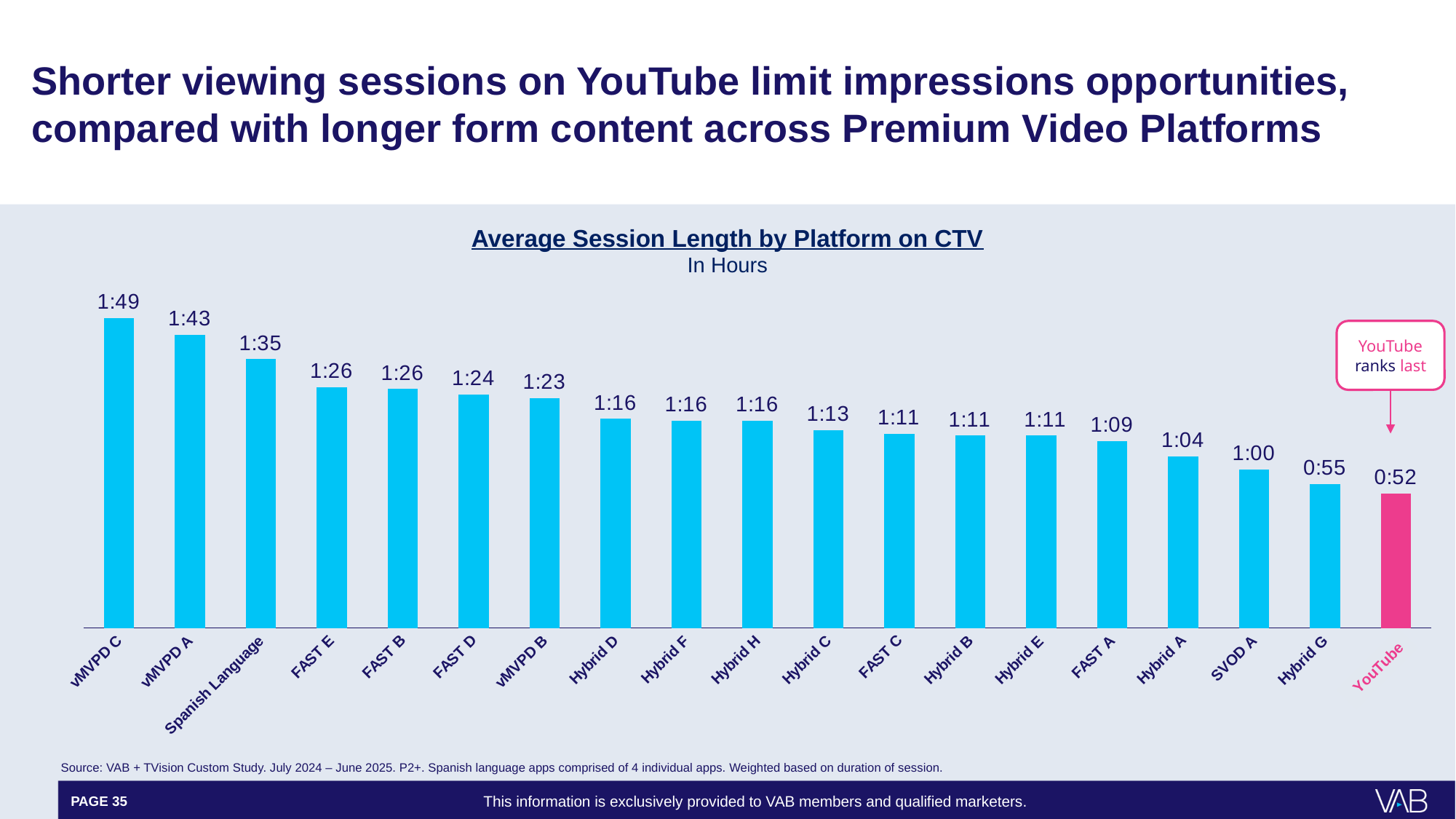
What type of chart is used to show average session length by platform? Bar chart What is the average session length for SVOD A? 1:00 What is the average session length for vMVPD C? 1:49 What is the average session length for Spanish Language? 1:35 Which platform has the shortest average session length? YouTube How many platforms are shown in the chart? 19 How many minutes longer is the average session on vMVPD C than on vMVPD A? 6 minutes What is the average session length for YouTube? 0:52 Which has a longer average session length, FAST E or Hybrid A? FAST E Do the values rise or fall moving from left to right across the chart? Fall Which platform has the longest average session length? vMVPD C Which bar is highlighted in a different colour (pink) from the others? YouTube